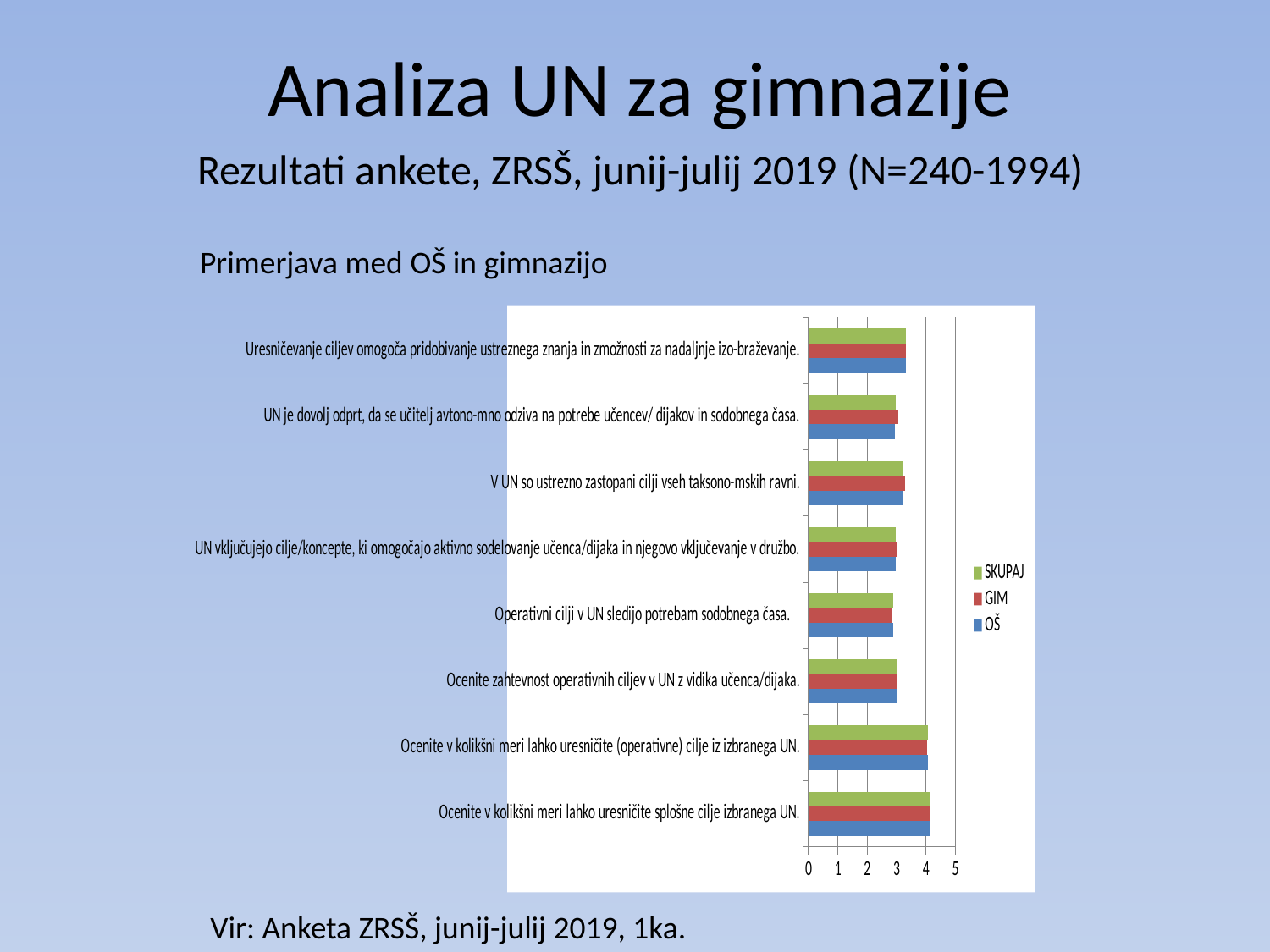
Is the SKUPAJ value for 'Uresničevanje ciljev omogoča pridobivanje ustreznega znanja in zmožnosti za nadaljnje izo-braževanje.' greater or less than 3? greater What kind of chart is shown on the slide? bar chart How many series does the chart legend list? 3 Which series are listed in the chart legend? SKUPAJ, GIM, OŠ What colour are the bars for the OŠ series? blue Which has the larger SKUPAJ value: 'Ocenite v kolikšni meri lahko uresničite splošne cilje izbranega UN.' or 'Operativni cilji v UN sledijo potrebam sodobnega časa.'? Ocenite v kolikšni meri lahko uresničite splošne cilje izbranega UN. Is the GIM value for 'Ocenite v kolikšni meri lahko uresničite (operativne) cilje iz izbranega UN.' greater or less than 3? greater What is the highest value shown on the chart's horizontal axis? 5 Is the OŠ value for 'Ocenite v kolikšni meri lahko uresničite splošne cilje izbranega UN.' greater or less than 5? less Which has the larger OŠ value: 'Ocenite v kolikšni meri lahko uresničite (operativne) cilje iz izbranega UN.' or 'Ocenite zahtevnost operativnih ciljev v UN z vidika učenca/dijaka.'? Ocenite v kolikšni meri lahko uresničite (operativne) cilje iz izbranega UN. How many categories (statements) are plotted on the chart? 8